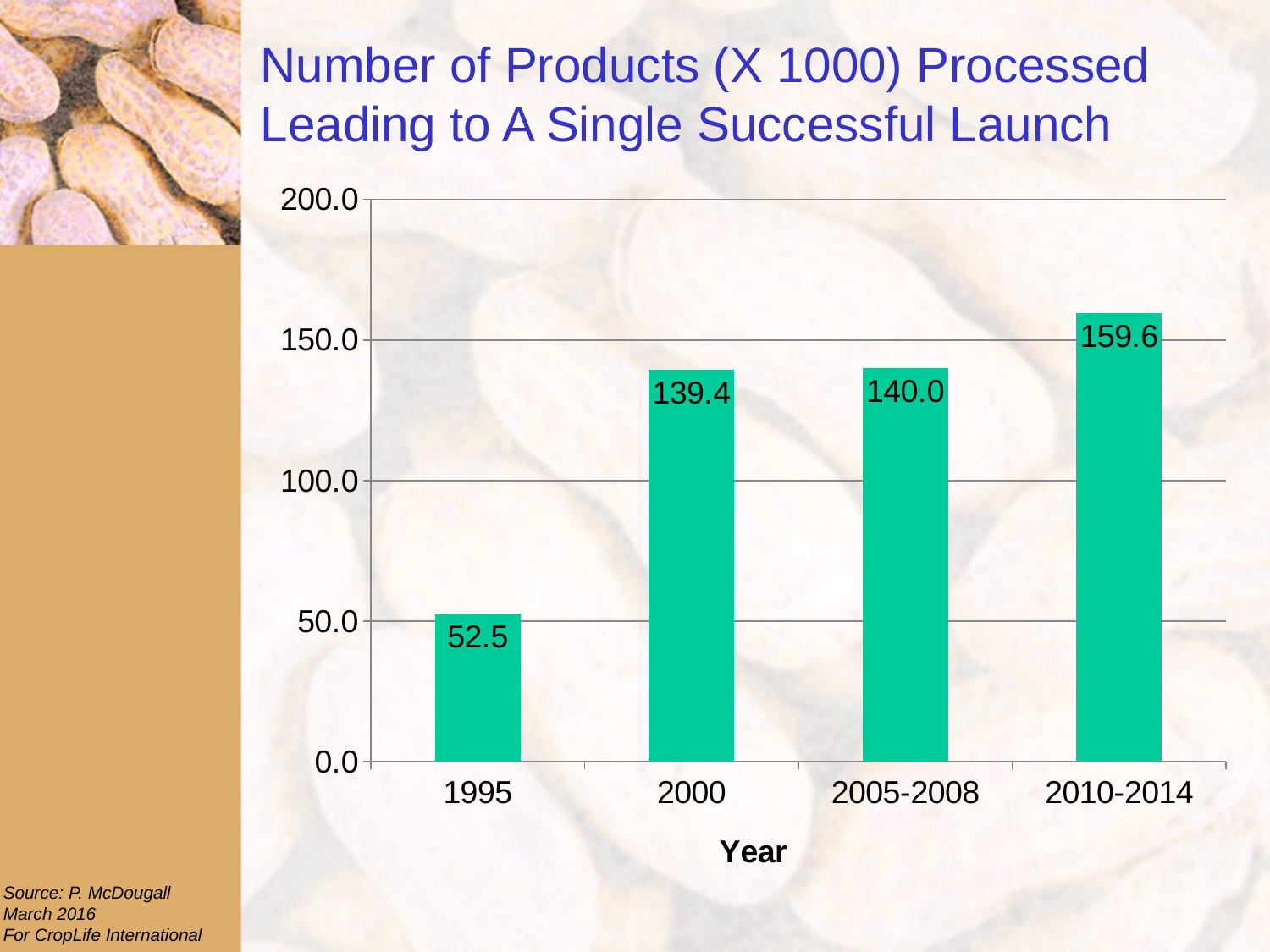
Is the value for 2000 greater or less than 100.0? greater What kind of chart is shown on the slide? Bar chart Which year has the lowest value? 1995 Which period has the highest value? 2010-2014 How many periods are shown on the x axis? 4 What is the difference between the values for 2010-2014 and 1995? 107.1 Do the values rise or fall from 1995 to 2010-2014? Rise What is the value for 1995? 52.5 What is the value for 2010-2014? 159.6 What is the value for 2005-2008? 140.0 What is the value for 2000? 139.4 Which is larger, the value for 2010-2014 or the value for 2000? 2010-2014